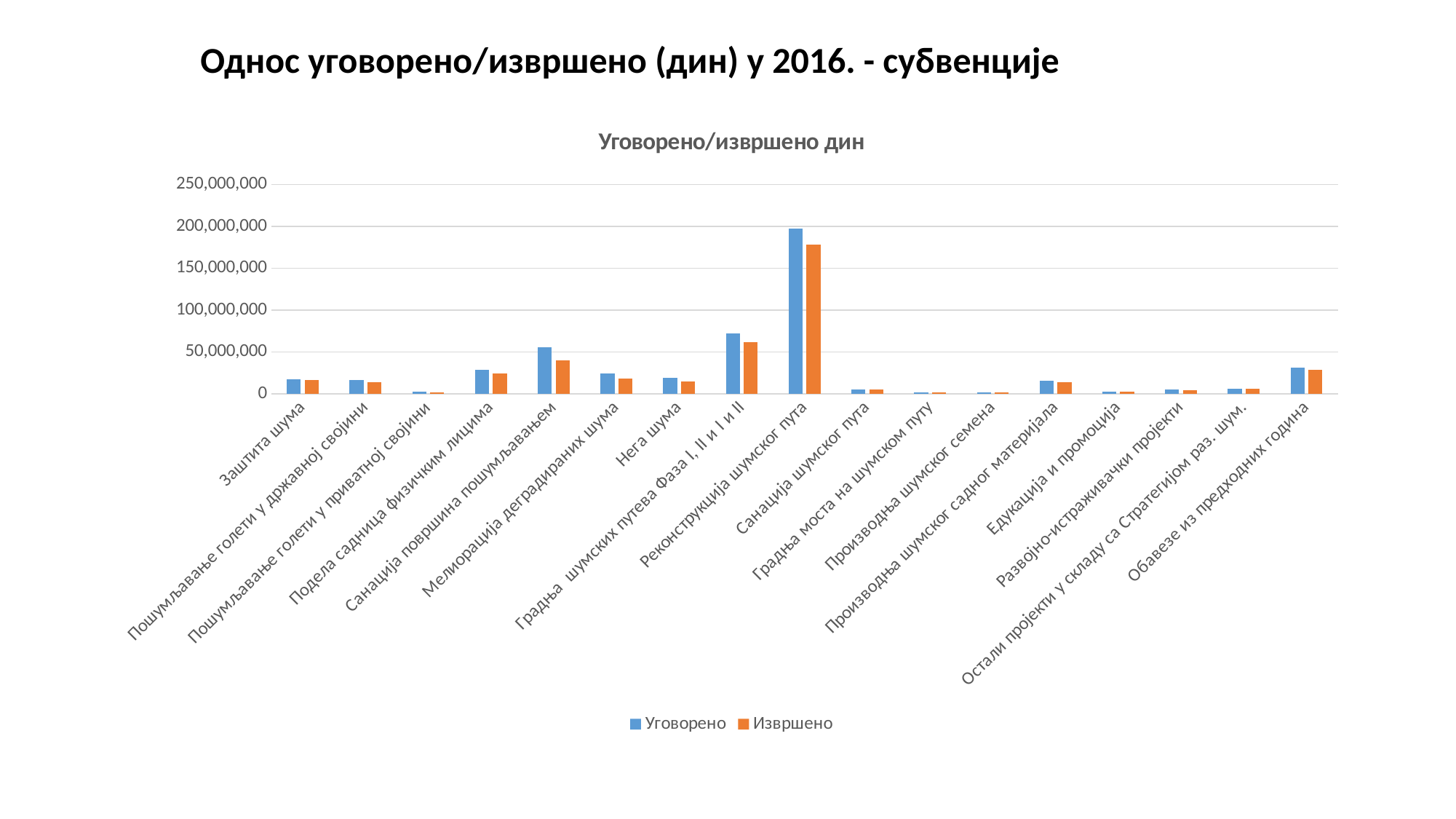
What are the two series named in the legend? Уговорено and Извршено Is the Уговорено value for Реконструкција шумског пута greater or less than 150,000,000? greater How many series does the legend list? 2 Is the Извршено value for Санација површина пошумљавањем greater or less than 50,000,000? less For Реконструкција шумског пута, which is larger: Уговорено or Извршено? Уговорено Is the Извршено value for Реконструкција шумског пута greater or less than 150,000,000? greater Which category has the highest Извршено value? Реконструкција шумског пута How many categories are shown on the x axis? 17 What type of chart is shown on the slide? bar chart Which category has the highest Уговорено value? Реконструкција шумског пута Which has the larger Уговорено value: Градња шумских путева Фаза I, II и I и II or Санација површина пошумљавањем? Градња шумских путева Фаза I, II и I и II